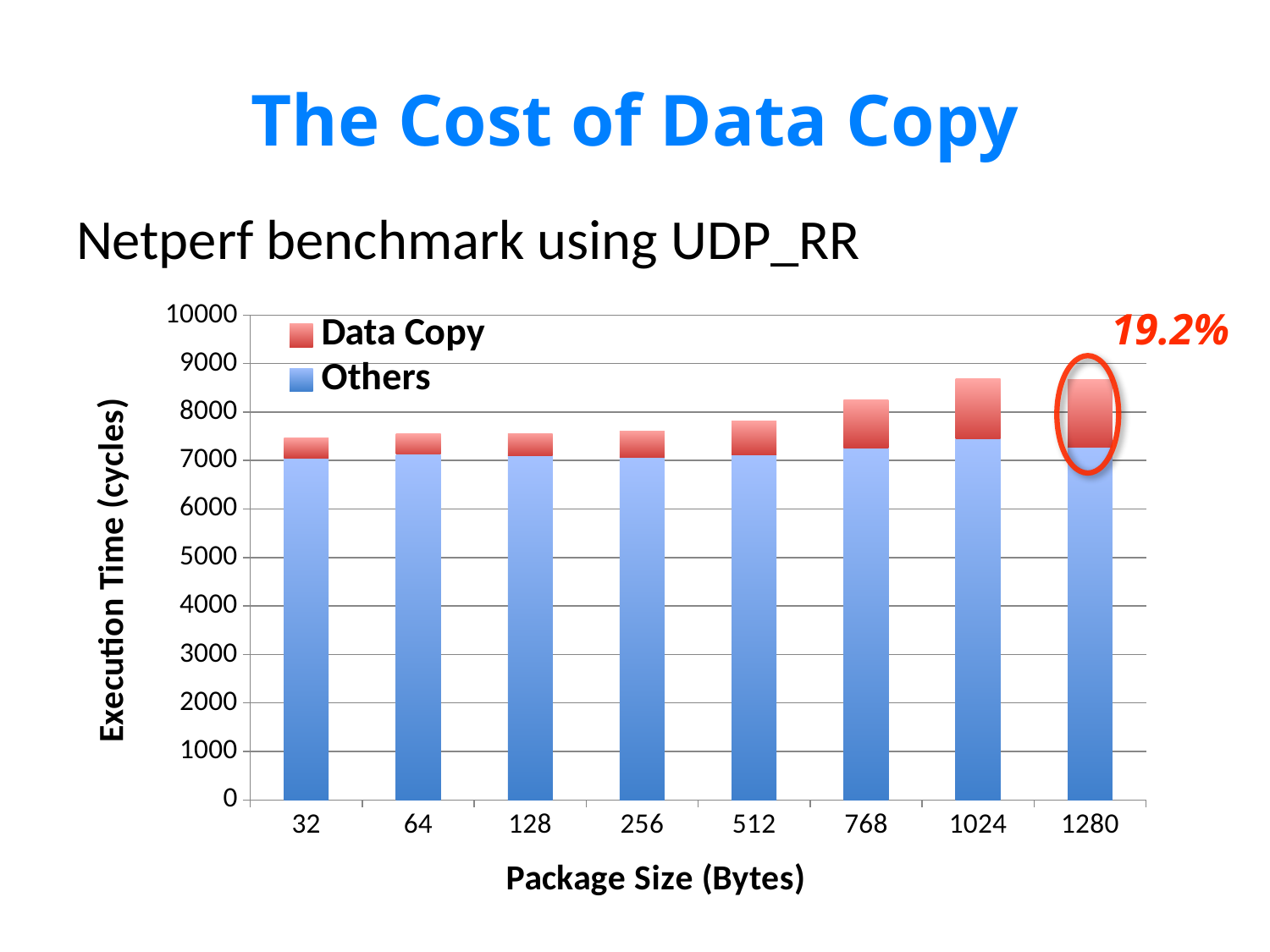
Is the total execution time for package size 32 greater or less than 8000 cycles? less Does the total execution time rise or fall as package size increases along the x axis? rise Is the total execution time for package size 768 greater or less than 8000 cycles? greater What percentage is annotated next to the circled Data Copy segment of the 1280-byte bar? 19.2% How many package sizes are shown on the x axis of the chart? 8 Is the total execution time for package size 1280 greater or less than 8000 cycles? greater What kind of chart is shown on the slide? stacked bar chart How many series does the chart's legend list? 2 Which has the larger total execution time, package size 32 or package size 1280? 1280 Which series is shown in red in the chart? Data Copy